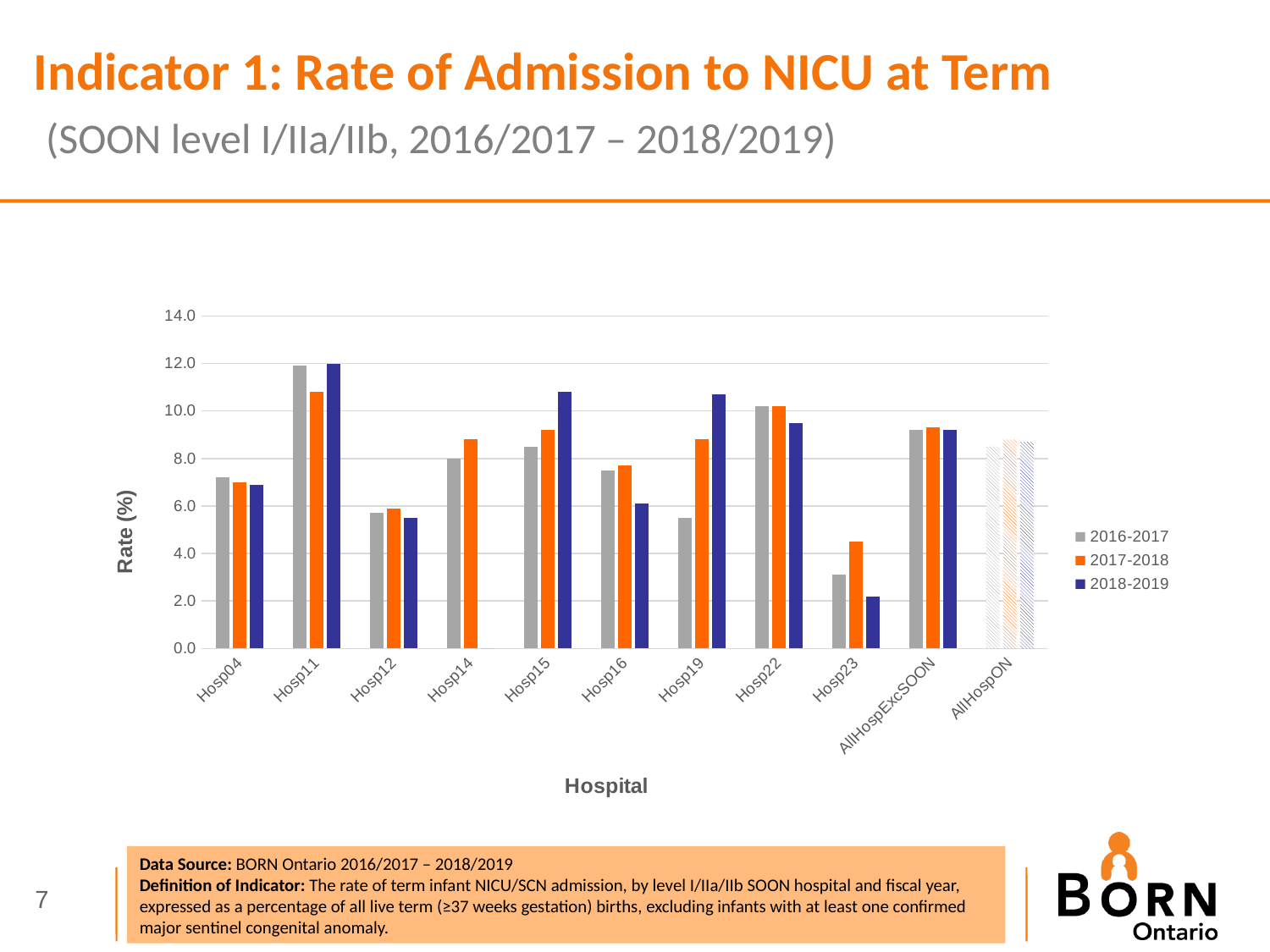
Is the 2016-2017 value for Hosp11 greater or less than 10.0? greater How many hospital categories are shown along the x axis? 11 For Hosp23, which year has the larger value, 2016-2017 or 2017-2018? 2017-2018 For Hosp16, which year has the larger value, 2016-2017 or 2018-2019? 2016-2017 Which hospital has the lowest NICU admission rate in 2018-2019? Hosp23 Is the 2018-2019 value for Hosp23 greater or less than 4.0? less Is the 2016-2017 value for Hosp19 greater or less than 6.0? less Which hospital has the highest NICU admission rate in 2016-2017? Hosp11 For Hosp19, do the values rise or fall from 2016-2017 to 2018-2019? Rise What is the label on the y axis of the chart? Rate (%) How many series does the legend list? 3 What kind of chart is shown on the slide? Bar chart